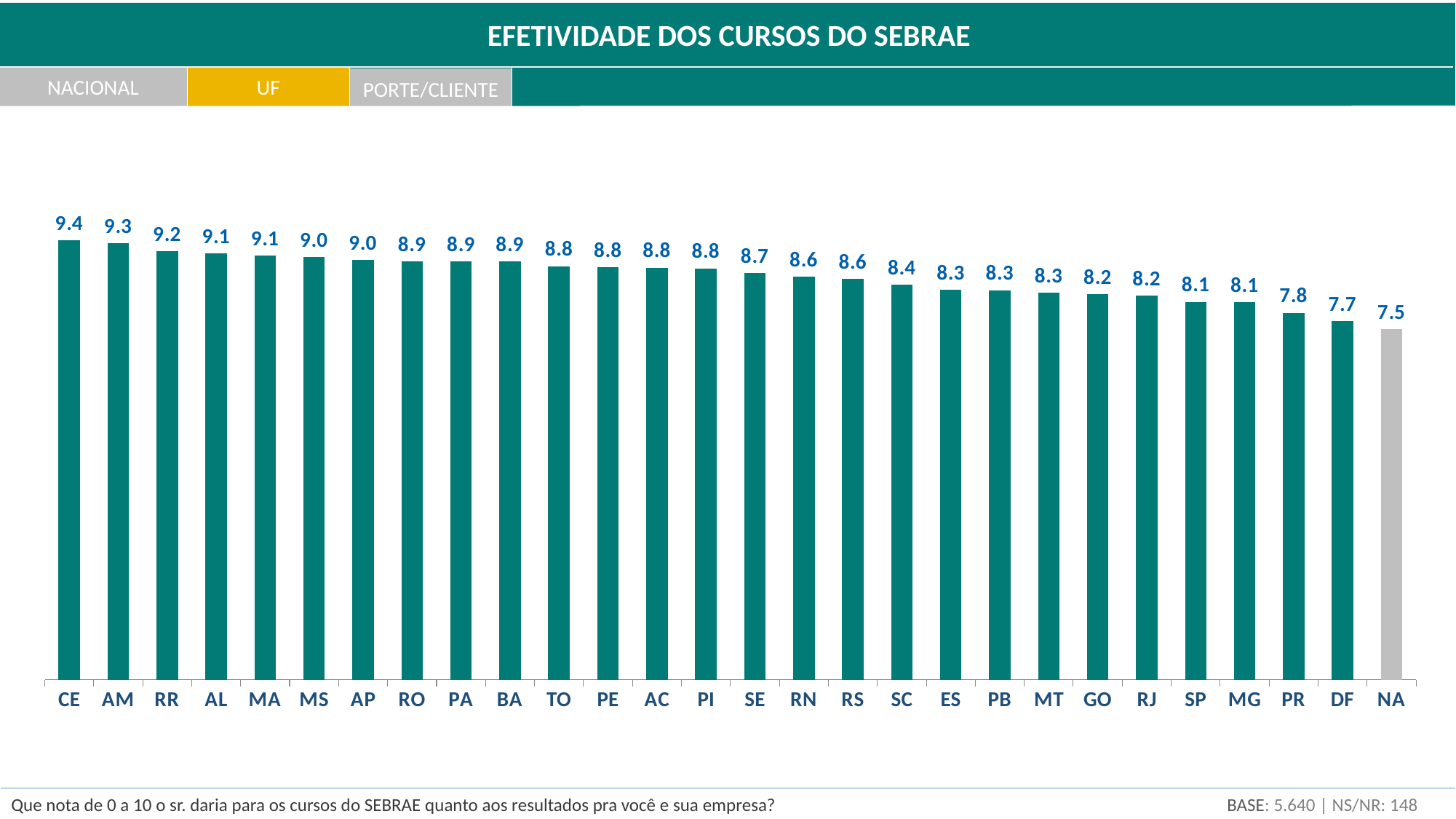
What is the difference between the values for AM and PR? 1.5 Which is larger, the value for RR or the value for SP? RR Do the values rise or fall from left to right along the x axis? fall What kind of chart is shown on the slide? bar chart What is the difference between the values for CE and NA? 1.9 How many categories are shown on the x axis? 28 Which category has the highest value? CE What is the value for DF? 7.7 What is the value for CE? 9.4 Which category has the lowest value? NA What is the value for SC? 8.4 What is the value for NA? 7.5